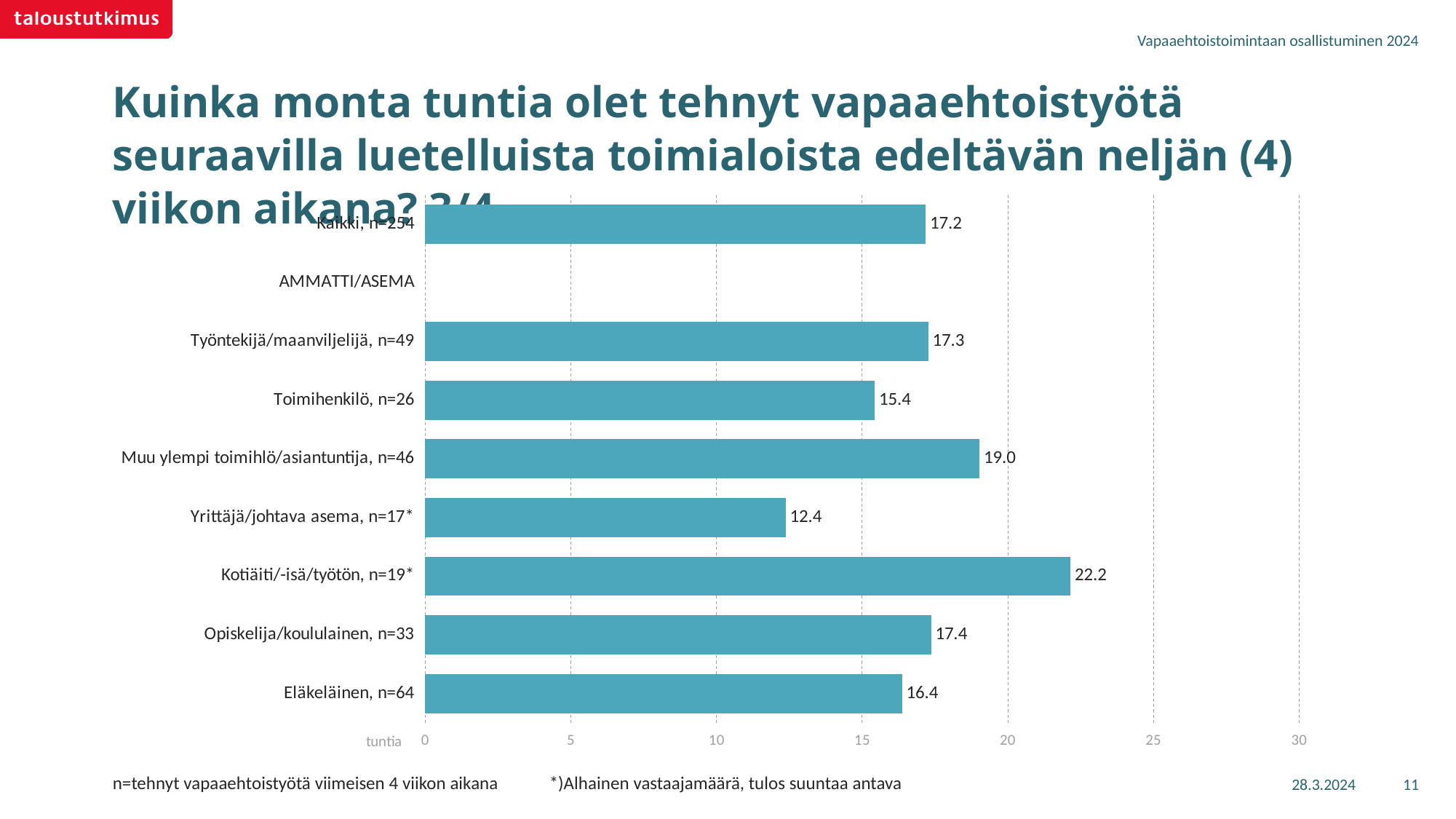
How many occupation groups are listed under AMMATTI/ASEMA with a bar? 7 What is the difference between the values for Muu ylempi toimihlö/asiantuntija, n=46 and Toimihenkilö, n=26? 3.6 How many hours are shown for Työntekijä/maanviljelijä, n=49? 17.3 What kind of chart is shown on the slide? bar chart Which category has the highest value? Kotiäiti/-isä/työtön, n=19* What is the value for Eläkeläinen, n=64? 16.4 What is the value for Toimihenkilö, n=26? 15.4 What unit label is shown on the horizontal axis? tuntia Which category has the lowest value? Yrittäjä/johtava asema, n=17* Which is larger, the value for Muu ylempi toimihlö/asiantuntija, n=46 or for Opiskelija/koululainen, n=33? Muu ylempi toimihlö/asiantuntija, n=46 What is the difference between the values for Kotiäiti/-isä/työtön, n=19* and Yrittäjä/johtava asema, n=17*? 9.8 Is the value for Kotiäiti/-isä/työtön, n=19* greater or less than 20? greater